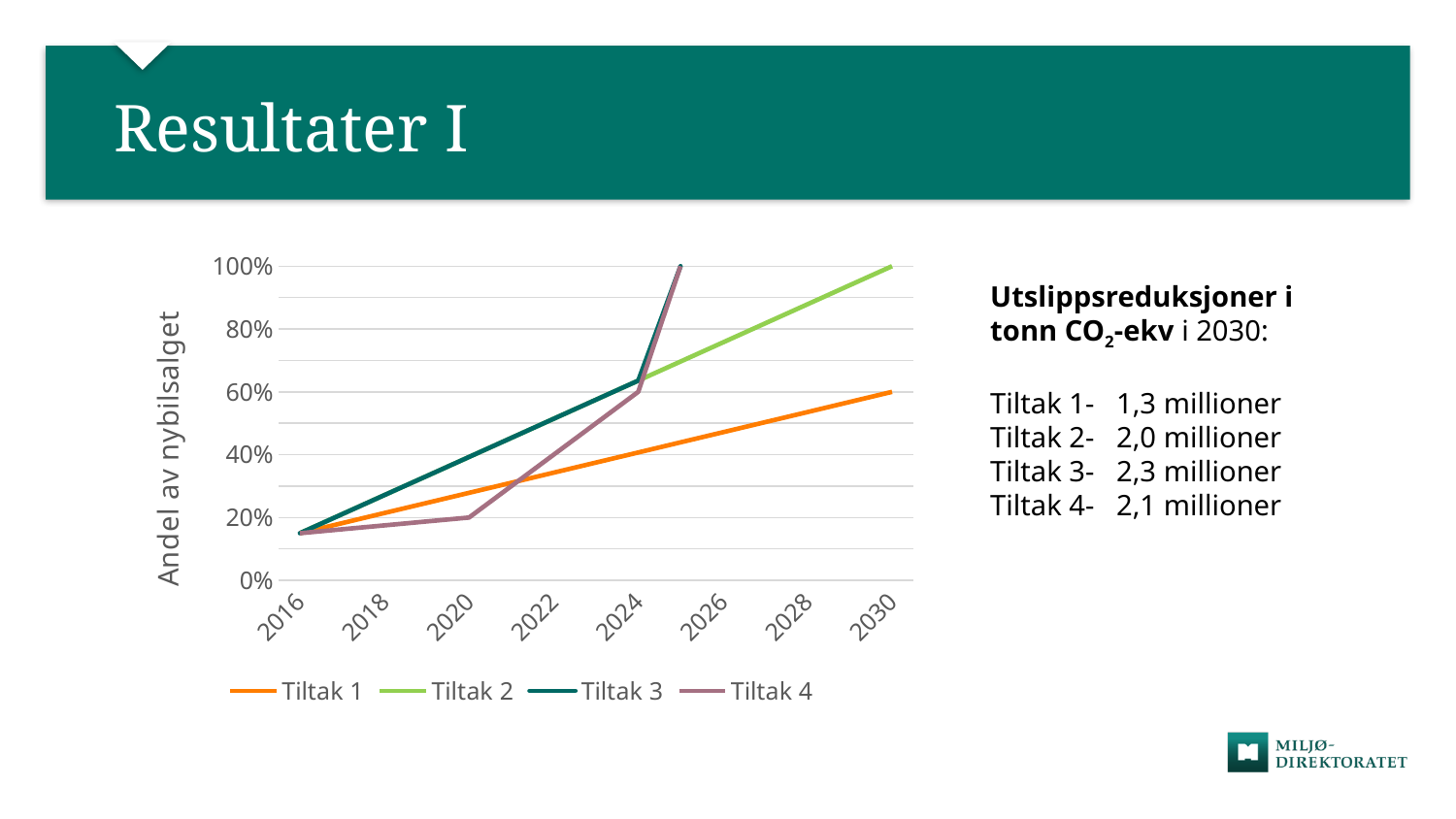
In 2022, which is larger: Tiltak 3 or Tiltak 4? Tiltak 3 What kind of chart is shown on the slide? line chart Which series has the lowest value in 2030? Tiltak 1 What value does Tiltak 2 reach in 2030? 100% What is the title of the vertical axis? Andel av nybilsalget What value does Tiltak 1 reach in 2030? 60% What is the difference between Tiltak 2 and Tiltak 1 in 2030? 40 percentage points Is the value for Tiltak 3 in 2022 greater or less than 40%? greater Do the values for Tiltak 1 rise or fall from 2016 to 2030? rise Is the value for Tiltak 1 in 2024 greater or less than 60%? less What is the value for Tiltak 4 in 2020? 20% How many series does the legend list? 4